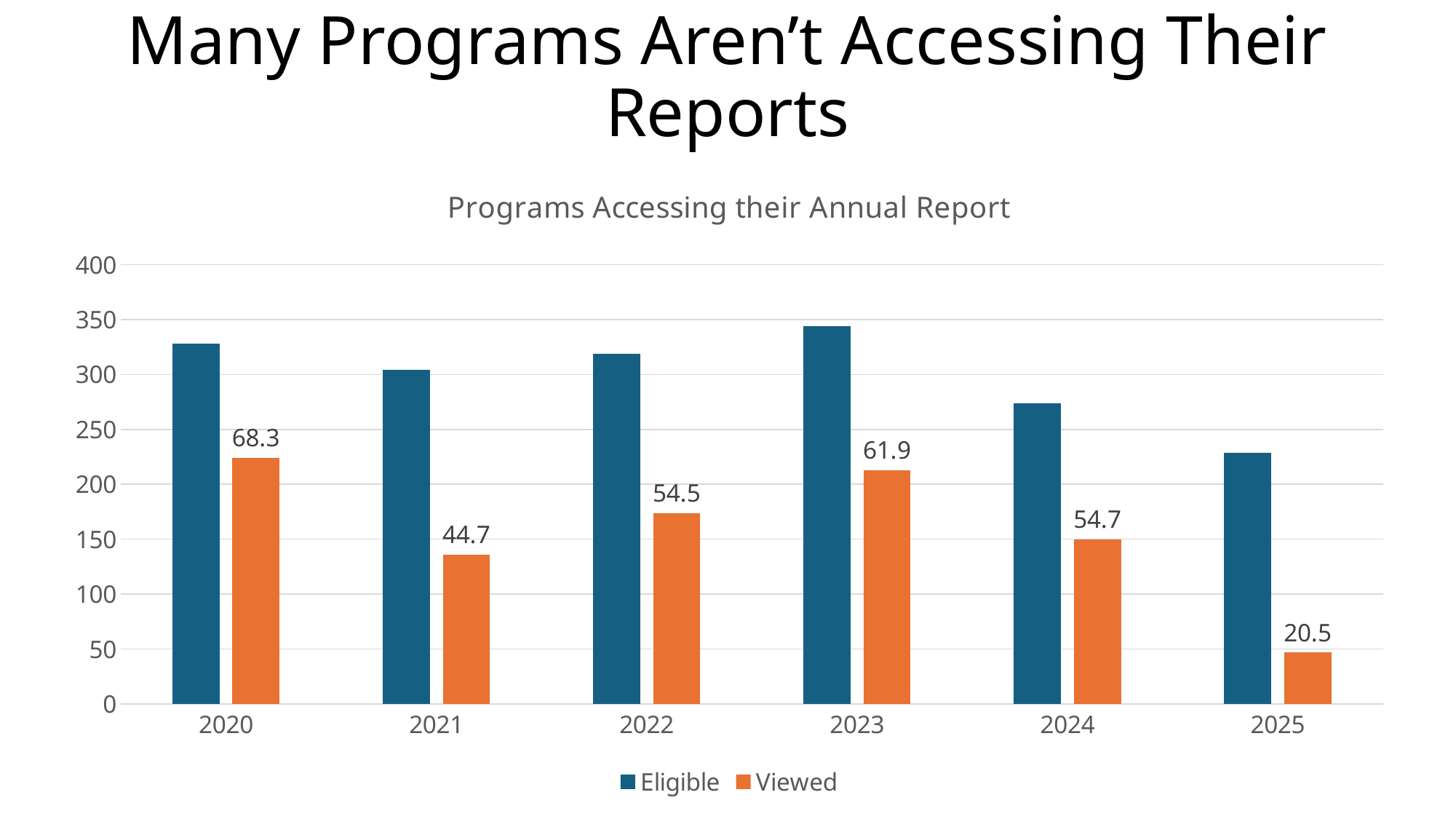
Which year has the lowest Viewed bar? 2025 What data label is shown on the Viewed bar for 2025? 20.5 Is the Eligible value for 2025 greater or less than 250? less What is the difference between the Viewed data labels for 2020 and 2025? 47.8 Is the Eligible value for 2024 greater or less than 250? greater How many years are shown on the x axis of the chart? 6 Which year has the highest Eligible bar? 2023 What type of chart is shown on the slide? bar chart What data label is shown on the Viewed bar for 2023? 61.9 What data label is shown on the Viewed bar for 2020? 68.3 How many series does the chart legend list? 2 What is the title of the chart? Programs Accessing their Annual Report